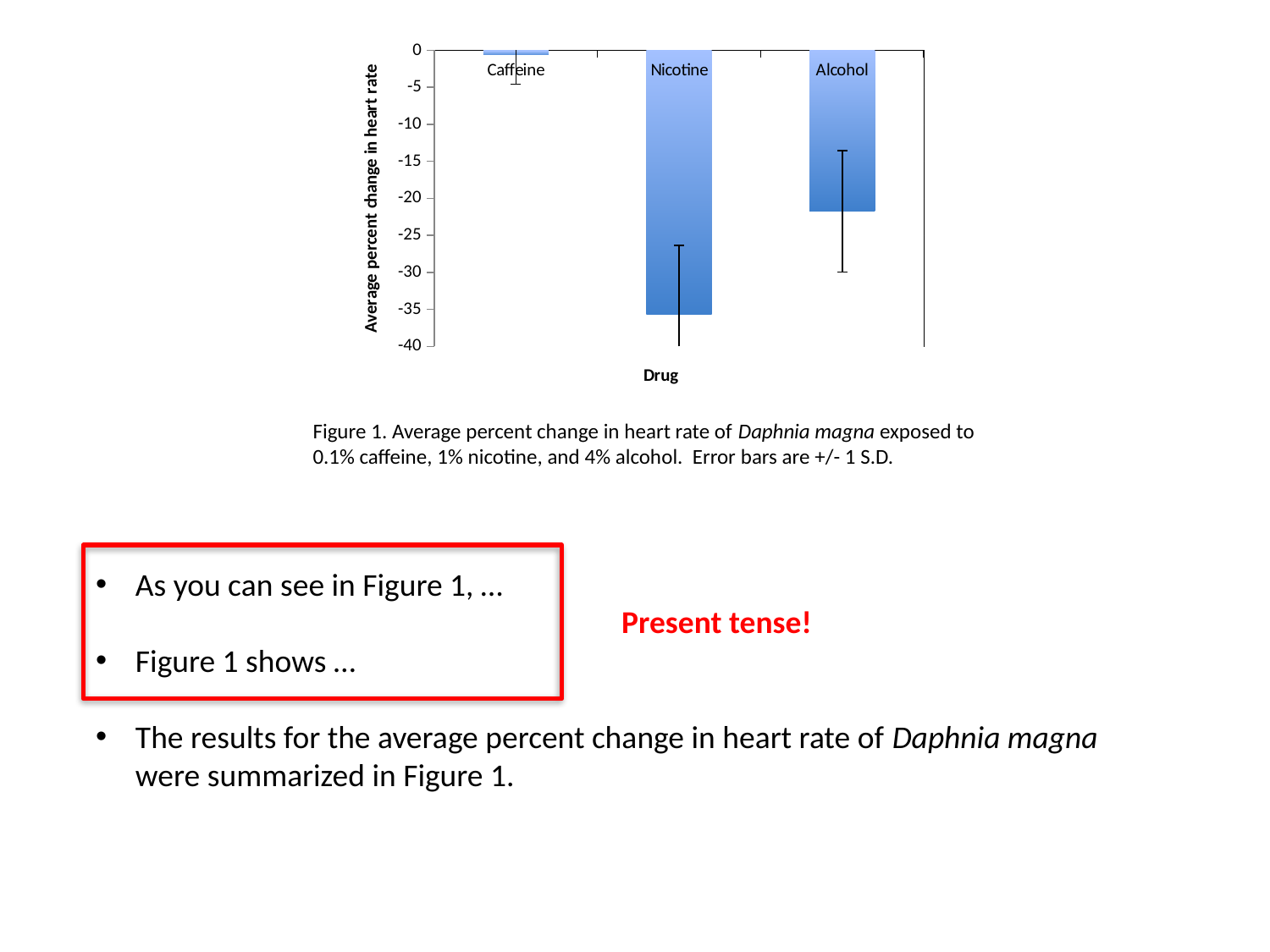
Which has the more negative average percent change in heart rate, Nicotine or Alcohol? Nicotine Is the value for Nicotine greater or less than -30? less Which has the more negative average percent change in heart rate, Caffeine or Alcohol? Alcohol How many drugs (categories) are plotted in the chart? 3 Which drug shows the smallest change in heart rate (value closest to 0)? Caffeine Is the value for Alcohol greater or less than -25? greater Which drug shows the largest decrease (most negative average percent change) in heart rate? Nicotine Is the value for Alcohol greater or less than -15? less What is the title of the horizontal axis of the chart? Drug What kind of chart is shown on the slide? bar chart What is the title of the vertical axis of the chart? Average percent change in heart rate